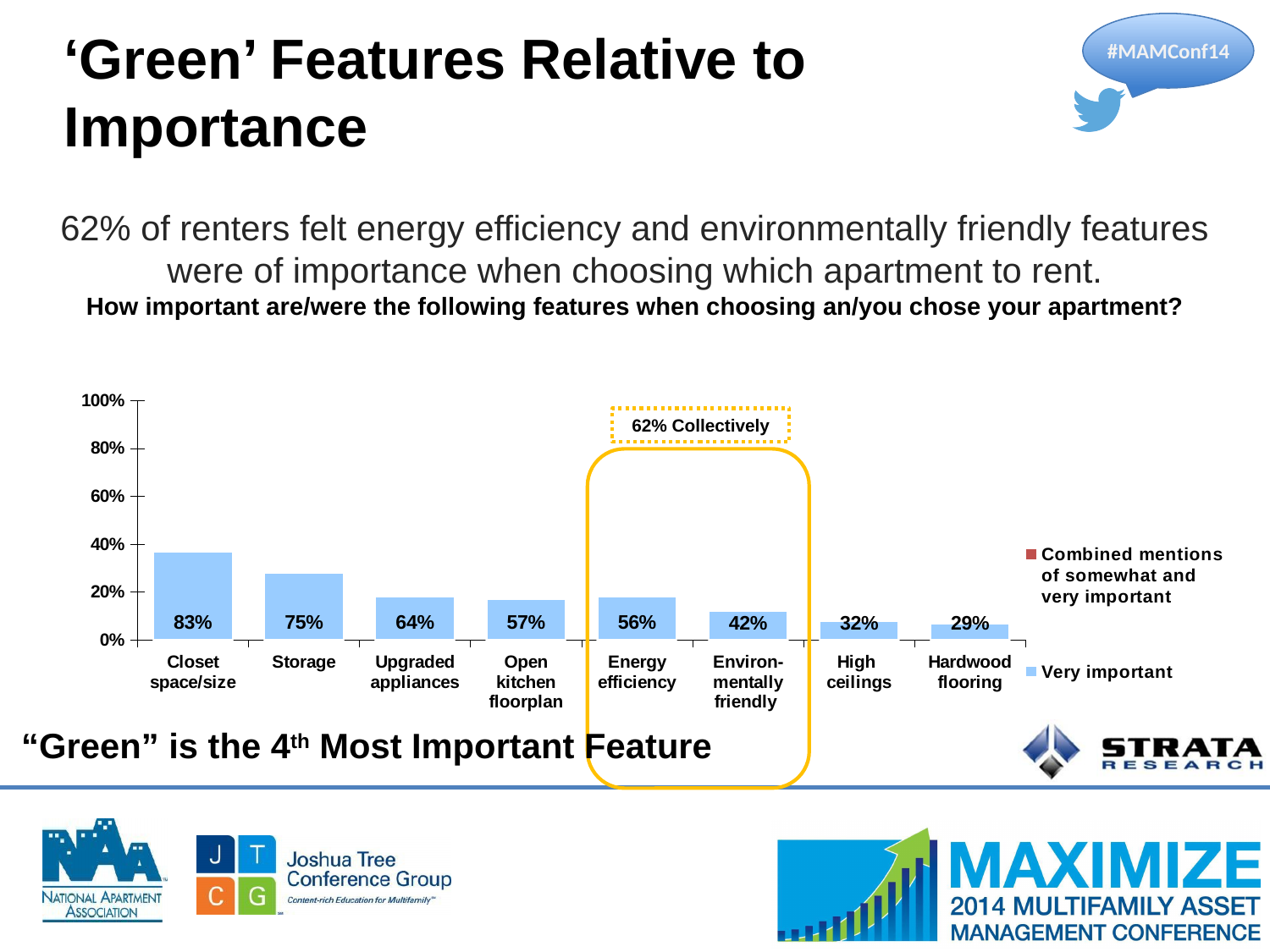
What data label is shown for Energy efficiency? 56% How many series does the legend list? 2 What data label is shown for Environmentally friendly? 42% How many features are shown on the x axis? 8 What kind of chart is shown on the slide? bar chart What data label is shown for High ceilings? 32% What is the difference between the labelled values for Closet space/size and Hardwood flooring? 54 percentage points Which feature has the highest labelled value? Closet space/size Which feature has the lowest labelled value? Hardwood flooring Do the labelled values rise or fall from left to right across the x axis? fall What data label is shown for Closet space/size? 83% Which has the larger labelled value, Storage or Upgraded appliances? Storage